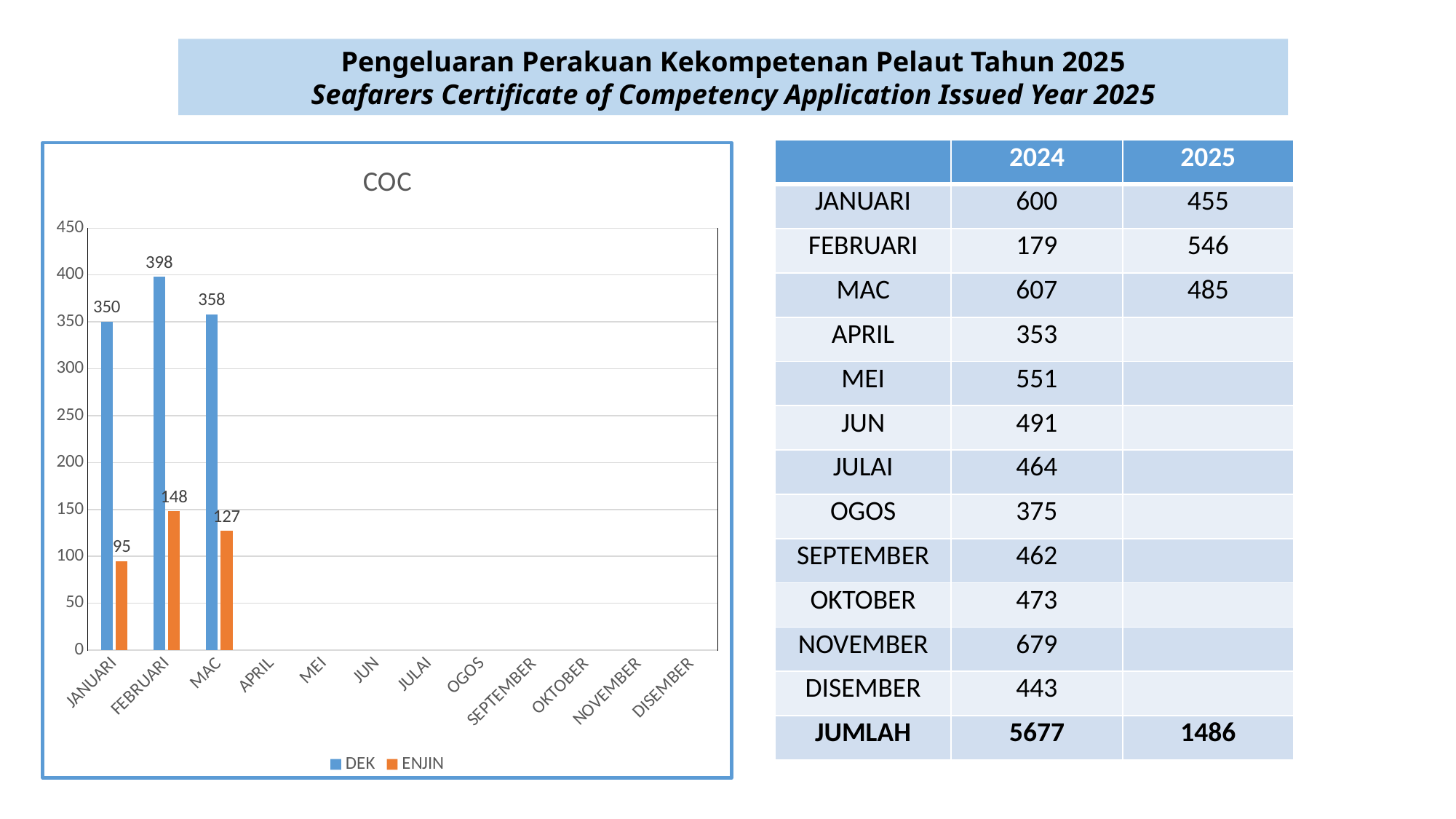
What is the ENJIN value for MAC in the COC chart? 127 What colour are the ENJIN bars in the COC chart? orange What is the DEK value for FEBRUARI in the COC chart? 398 Which month has the highest DEK value in the COC chart? FEBRUARI What is the ENJIN value for JANUARI in the COC chart? 95 In the COC chart, which is larger: the DEK value for JANUARI or the DEK value for MAC? MAC How many month categories are shown on the x axis of the COC chart? 12 What is the difference between the DEK and ENJIN values for MAC in the COC chart? 231 Which month has the lowest ENJIN value among the plotted months in the COC chart? JANUARI Is the ENJIN value for FEBRUARI in the COC chart greater or less than 100? greater How many series does the legend of the COC chart list? 2 What kind of chart is the COC chart? bar chart